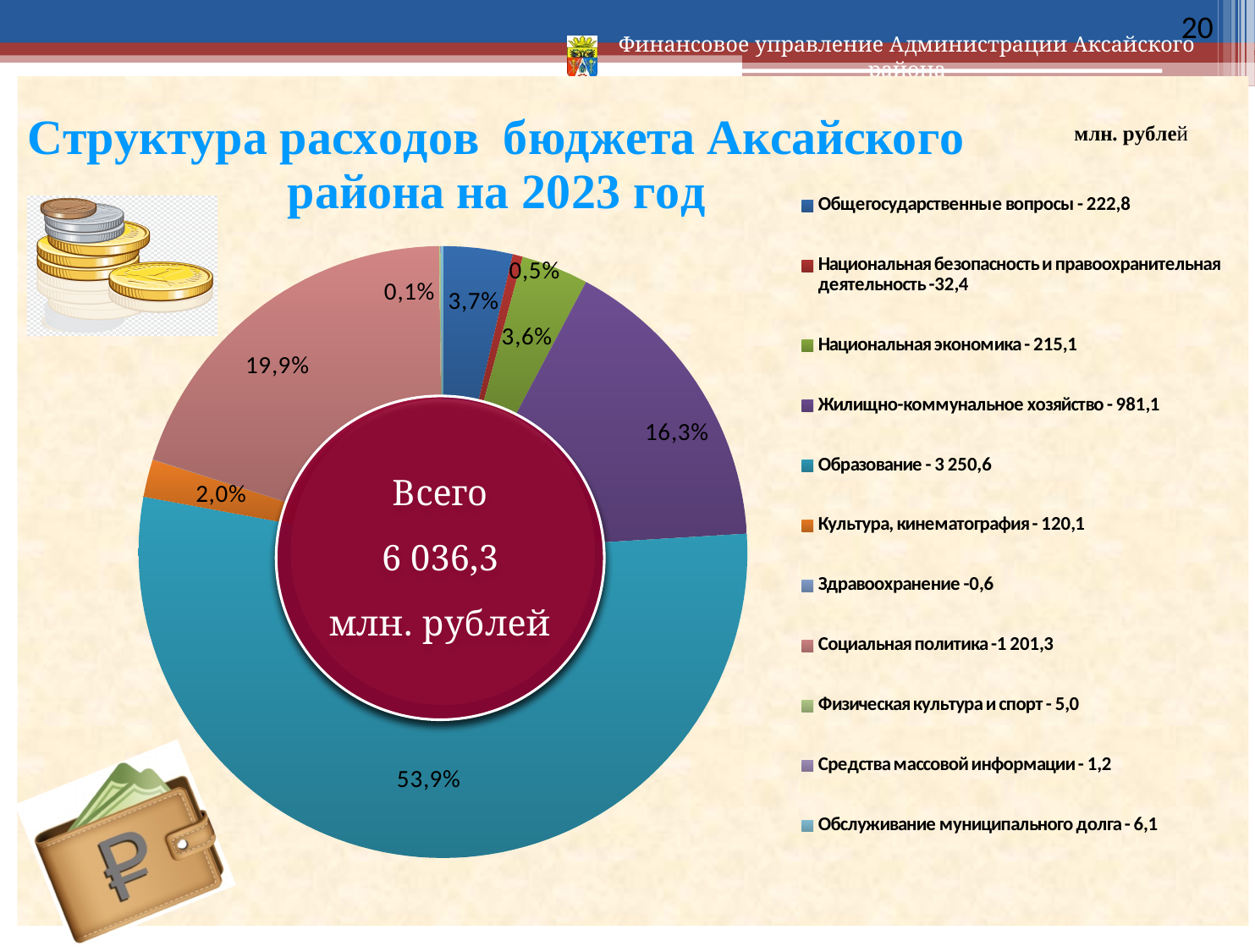
What type of chart is shown on the slide? doughnut chart How many categories are listed in the legend? 11 What total is shown in the centre of the chart? 6 036,3 млн. рублей What is the value for Жилищно-коммунальное хозяйство? 981,1 What is the value for Социальная политика? 1 201,3 What is the difference between Образование and Жилищно-коммунальное хозяйство? 2 269,5 What share of the pie does Жилищно-коммунальное хозяйство take? 16,3% Which category has the smallest expenditure? Здравоохранение What share of the pie does Образование take? 53,9% Which category has the largest expenditure? Образование What is the value for Образование in the legend? 3 250,6 Which is larger: Общегосударственные вопросы or Национальная экономика? Общегосударственные вопросы